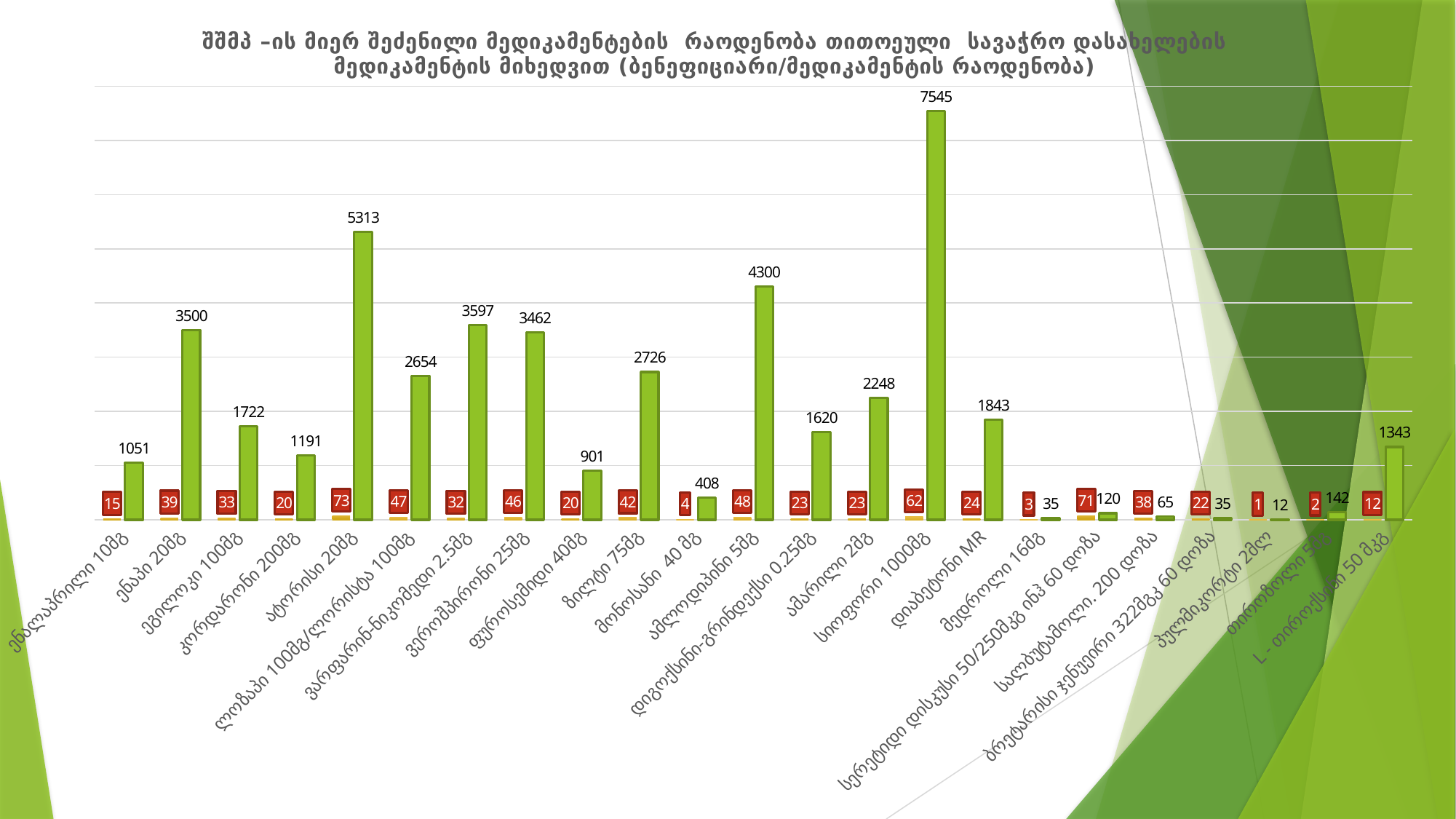
How many categories are shown on the x axis? 23 What is the value shown for სიოფორი 1000მგ? 7545 What is the value shown for L - თიროქსინი 50 მკგ? 1343 Which category has the highest bar? სიოფორი 1000მგ Which is larger, the value for ამლოდიპინი 5მგ or the value for ვარფარინ-ნიკომედი 2.5მგ? ამლოდიპინი 5მგ What is the value shown for ატორისი 20მგ? 5313 What is the value shown for ზილტი 75მგ? 2726 What kind of chart is shown on the slide? bar chart Which category has the lowest value? პულმიკორტი 2მლ What is the difference between the values for სიოფორი 1000მგ and ატორისი 20მგ? 2232 What is the red label value shown for ატორისი 20მგ? 73